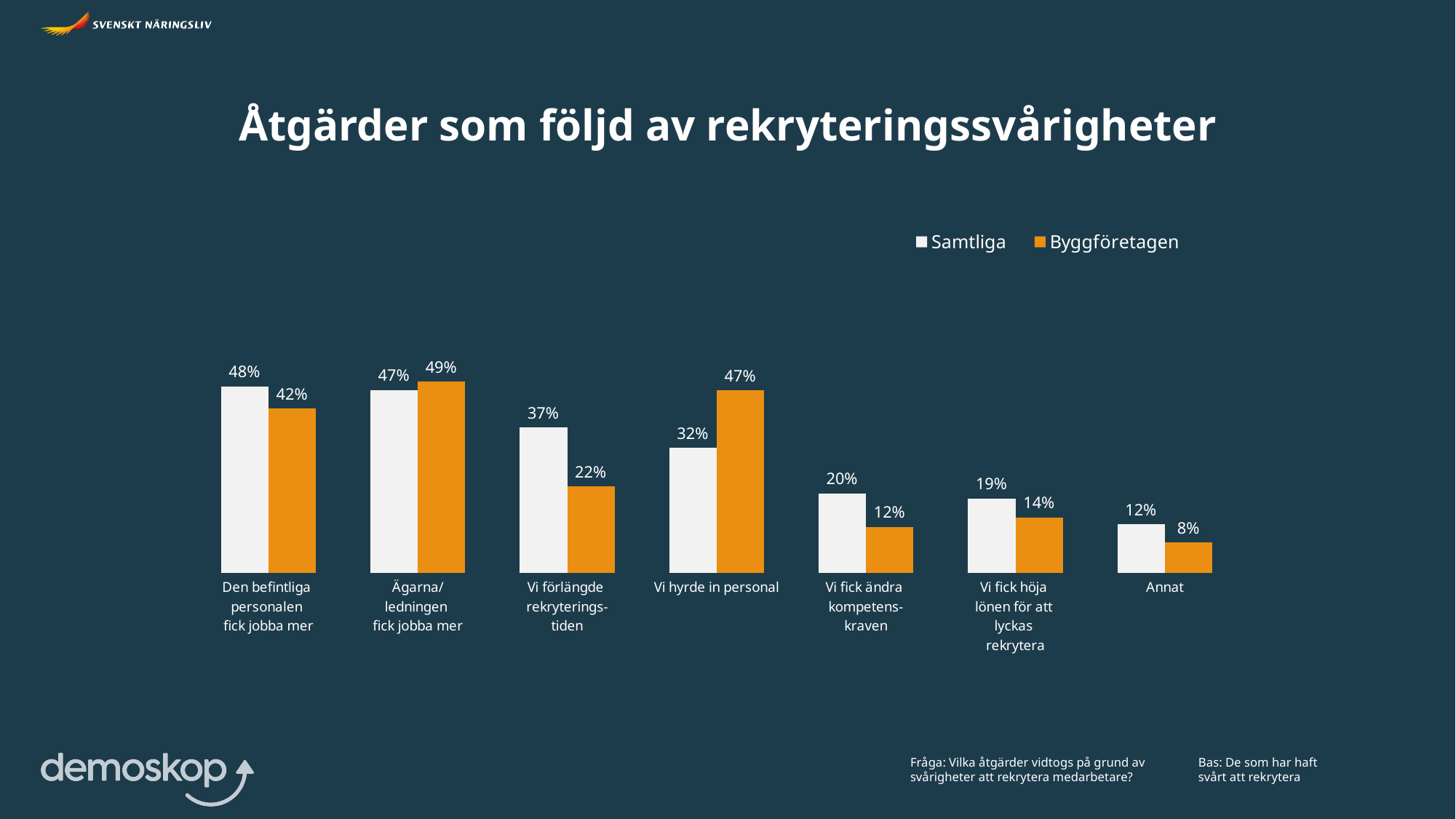
What is the difference between the Samtliga and Byggföretagen values for 'Vi hyrde in personal'? 15 percentage points Which colour represents the Byggföretagen series? Orange What is the Samtliga value for 'Vi hyrde in personal'? 32% What is the Byggföretagen value for 'Annat'? 8% How many categories are shown on the x axis? 7 What kind of chart is shown on the slide? Bar chart Which category has the highest Byggföretagen value? Ägarna/ledningen fick jobba mer How many series does the legend list? 2 Which category has the lowest Samtliga value? Annat What is the Byggföretagen value for 'Vi förlängde rekryteringstiden'? 22% For 'Vi fick ändra kompetenskraven', which series has the larger value, Samtliga or Byggföretagen? Samtliga What is the title of the chart? Åtgärder som följd av rekryteringssvårigheter